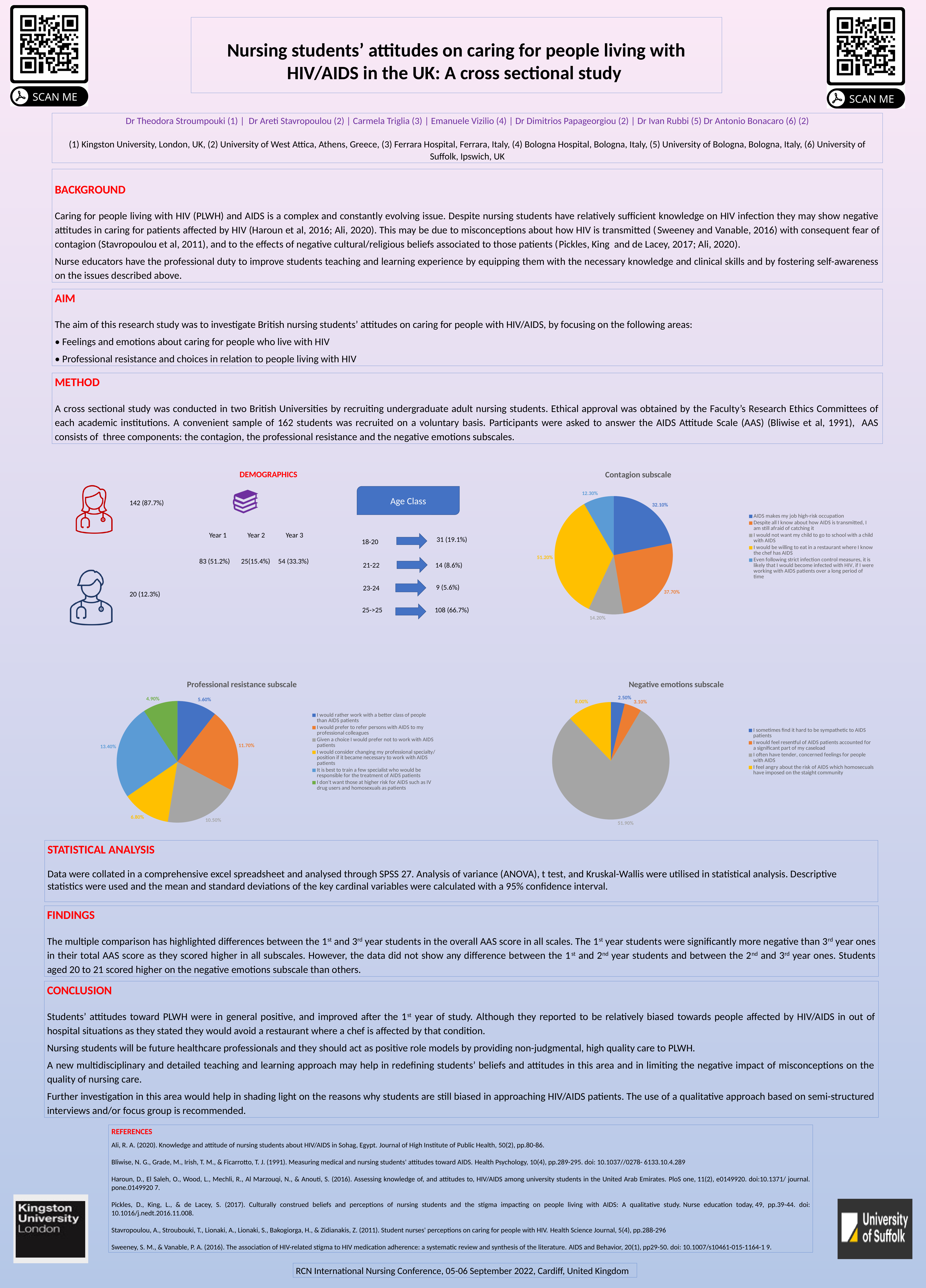
What type of chart is the Professional resistance subscale chart? Pie chart On the Negative emotions subscale chart, which is larger: the value for 'I would feel resentful of AIDS patients accounted for a significant part of my caseload' or the value for 'I feel angry about the risk of AIDS which homosexuals have imposed on the staight community'? I feel angry about the risk of AIDS which homosexuals have imposed on the staight community On the Professional resistance subscale chart, what value is shown for 'It is best to train a few specialist who would be responsible for the treatment of AIDS patients'? 13.40% How many entries does the legend of the Negative emotions subscale chart list? 4 How many entries does the legend of the Contagion subscale chart list? 5 How many slices does the Professional resistance subscale pie chart have? 6 On the Contagion subscale chart, which slice has the smallest value? Even following strict infection control measures, it is likely that I would become infected with HIV, if I were working with AIDS patients over a long period of time On the Professional resistance subscale chart, which slice has the smallest value? I don't want those at higher risk for AIDS such as IV drug users and homosexuals as patients On the Negative emotions subscale chart, what value is shown for 'I often have tender, concerned feelings for people with AIDS'? 51.90% On the Contagion subscale chart, what value is shown for 'AIDS makes my job high-risk occupation'? 32.10% On the Contagion subscale chart, what value is shown for the slice 'I would be willing to eat in a restaurant where I know the chef has AIDS'? 51.20% On the Contagion subscale chart, what is the difference between the 37.70% slice and the 14.20% slice? 23.50%